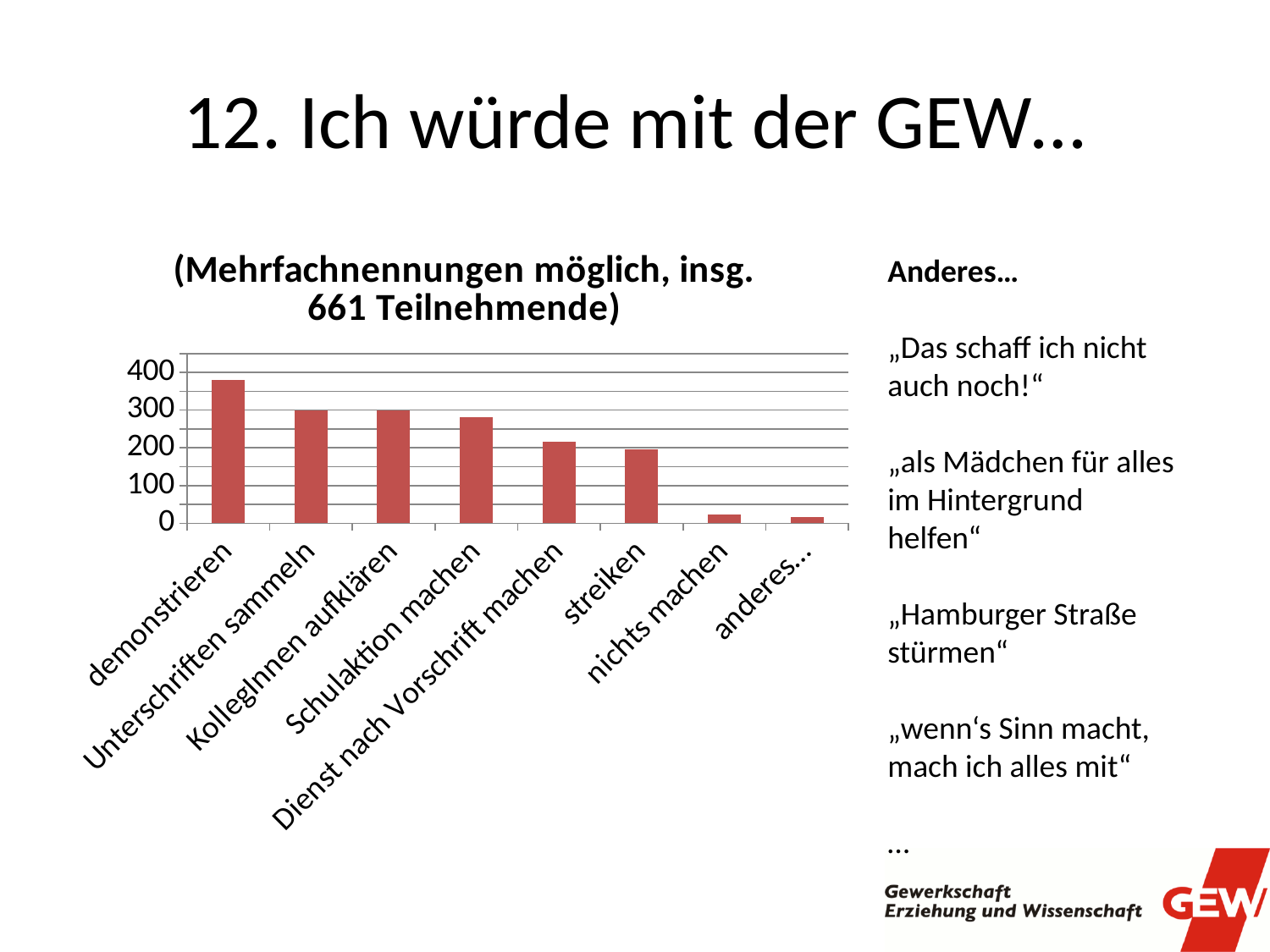
Is the value for nichts machen greater or less than 100? less Which is larger, the value for demonstrieren or the value for streiken? demonstrieren What is the title of the chart? (Mehrfachnennungen möglich, insg. 661 Teilnehmende) Is the value for Schulaktion machen greater or less than 300? less Which is larger, the value for Schulaktion machen or the value for nichts machen? Schulaktion machen What colour are the bars in the chart? red Is the value for Dienst nach Vorschrift machen greater or less than 200? greater What kind of chart is shown on the slide? bar chart Do the bar values generally rise or fall from left to right along the x axis? fall Which category has the highest value in the chart? demonstrieren How many categories are shown on the x axis of the chart? 8